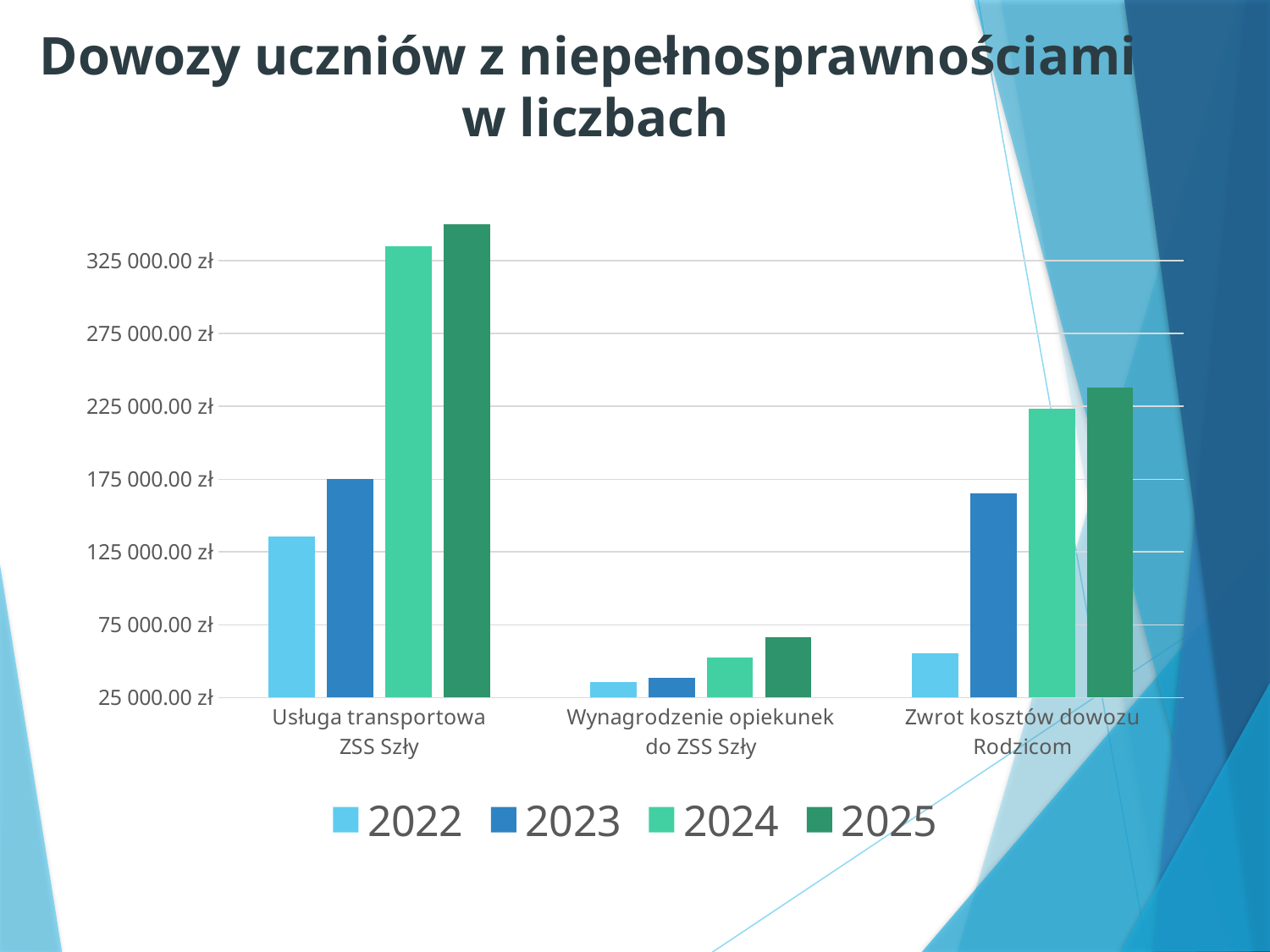
Is the 2025 value for Wynagrodzenie opiekunek do ZSS Szły greater or less than 75 000.00 zł? less Which category has the highest value for 2025? Usługa transportowa ZSS Szły Is the 2024 value for Usługa transportowa ZSS Szły greater or less than 325 000.00 zł? greater How many categories are shown on the x axis? 3 What is the title of the chart? Dowozy uczniów z niepełnosprawnościami w liczbach Do the values for Usługa transportowa ZSS Szły rise or fall from 2022 to 2025? rise What kind of chart is shown on the slide? bar chart Which category has the lowest value for 2024? Wynagrodzenie opiekunek do ZSS Szły Which years are listed in the legend? 2022, 2023, 2024, 2025 Which is larger for 2024: Usługa transportowa ZSS Szły or Zwrot kosztów dowozu Rodzicom? Usługa transportowa ZSS Szły Is the 2025 value for Zwrot kosztów dowozu Rodzicom greater or less than 225 000.00 zł? greater How many series does the legend list? 4